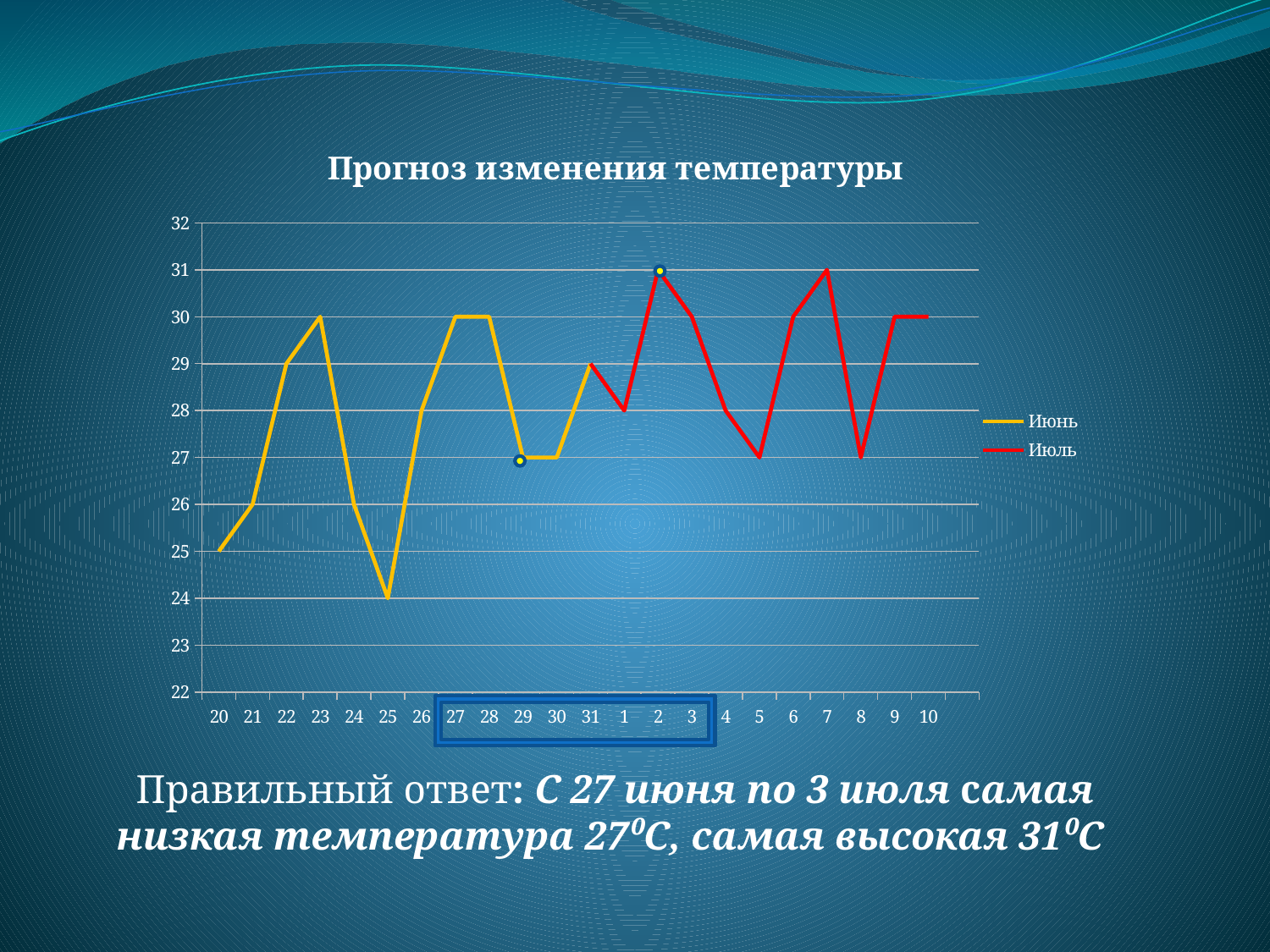
Which is larger: the Июль value for 5 or the Июль value for 6? 6 What is the temperature value for 25 in the Июнь series? 24 What is the temperature value for 2 in the Июль series? 31 On which day does the Июнь series reach its lowest value? 25 How many series does the legend list? 2 What is the title of the chart? Прогноз изменения температуры What is the difference between the Июнь value for 23 and the Июнь value for 25? 6 What is the highest value reached by the Июль series? 31 Is the Июнь value for 22 greater or less than 28? greater What kind of chart is shown on the slide? line chart What is the temperature value for 20 in the Июнь series? 25 What are the two series named in the legend? Июнь, Июль